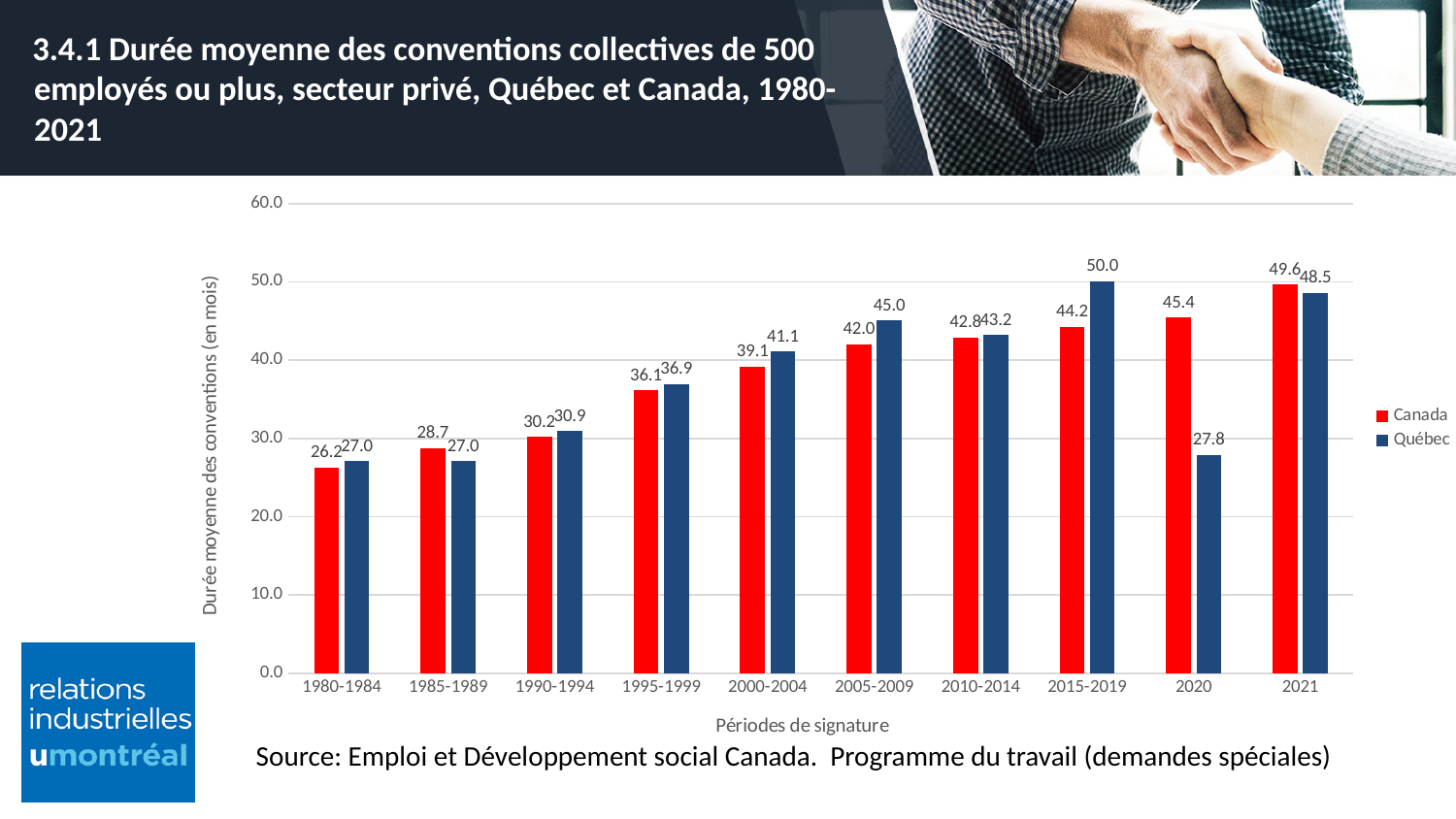
What is the value for Québec in 2020? 27.8 Which period has the lowest value for Canada? 1980-1984 What is the value for Canada in 2021? 49.6 What is the value for Canada in 1980-1984? 26.2 Which period has the highest value for Québec? 2015-2019 Which is larger in 2005-2009, the Canada value or the Québec value? Québec How many series does the legend list? 2 What kind of chart is shown on the slide? bar chart How many periods are shown on the x axis? 10 What is the value for Québec in 2015-2019? 50.0 Is the value for Canada in 2015-2019 greater or less than 40.0? greater What is the difference between the Québec and Canada values in 2020? 17.6